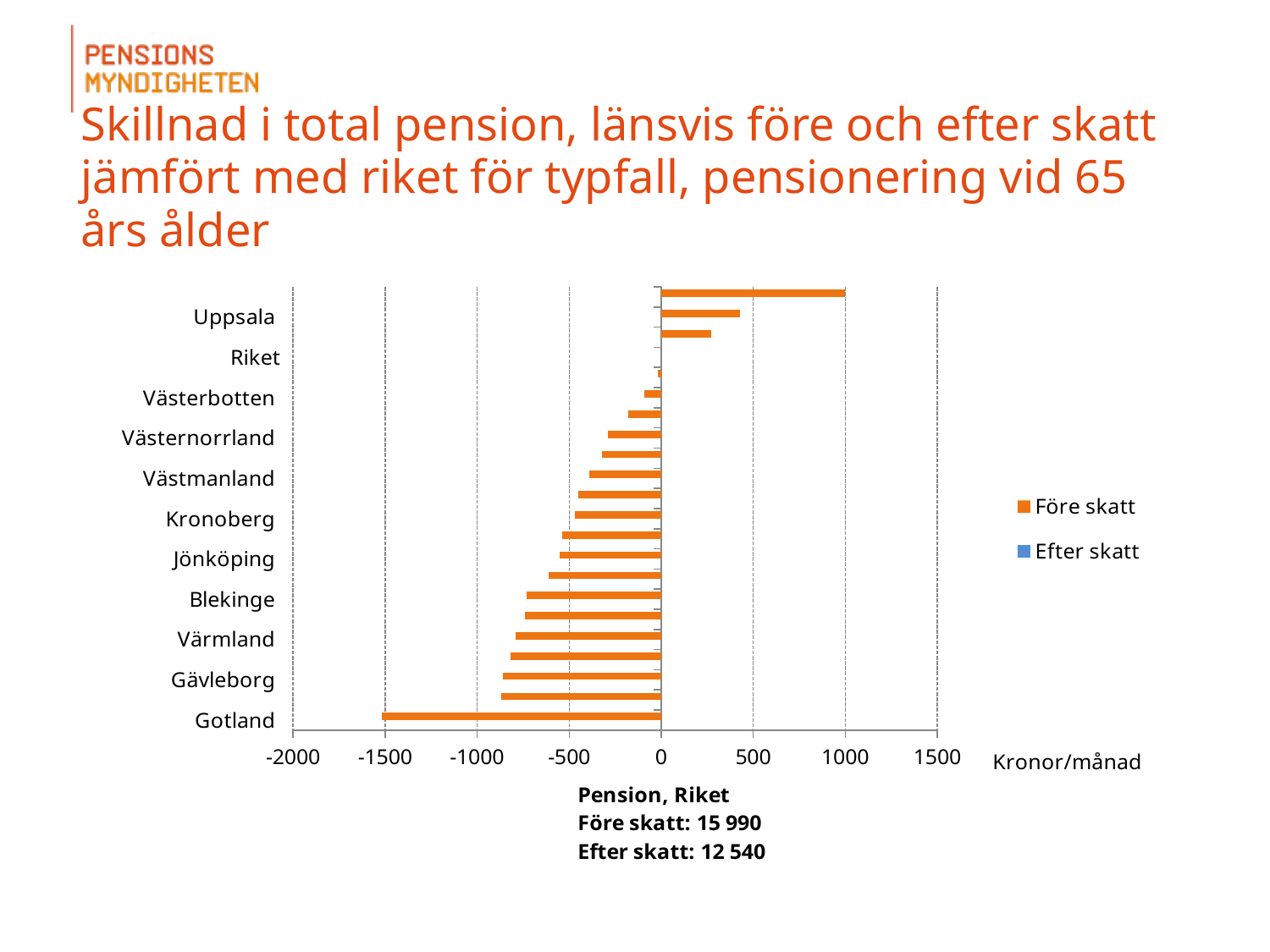
Is the value for Gävleborg greater or less than -500? less Is the value for Värmland greater or less than -500? less Which labelled county has the lowest value in the chart? Gotland What kind of chart is shown on the slide? bar chart Is the value for Västerbotten greater or less than -500? greater Which labelled county has the highest value in the chart? Uppsala How many series does the legend list? 2 Which has the larger value, Uppsala or Västerbotten? Uppsala Which has the lower value, Gotland or Gävleborg? Gotland What unit is shown on the horizontal axis label of the chart? Kronor/månad